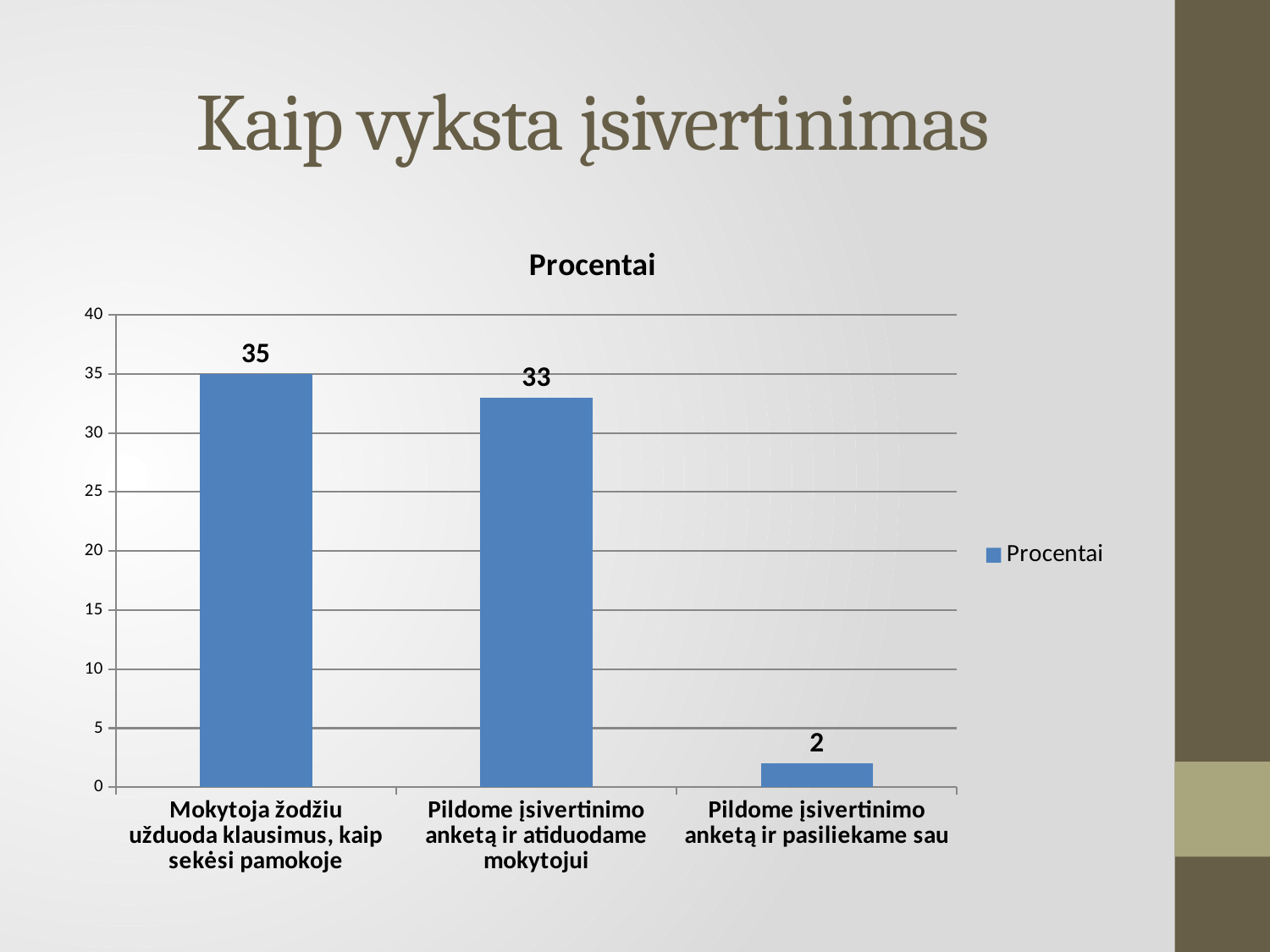
What kind of chart is shown on the slide? bar chart What is the difference between the values for "Pildome įsivertinimo anketą ir atiduodame mokytojui" and "Pildome įsivertinimo anketą ir pasiliekame sau"? 31 Is the value for "Pildome įsivertinimo anketą ir pasiliekame sau" greater or less than 5? less Which category has the highest value? Mokytoja žodžiu užduoda klausimus, kaip sekėsi pamokoje What is the value for "Pildome įsivertinimo anketą ir atiduodame mokytojui"? 33 How many series does the legend list? 1 What is the difference between the values for "Mokytoja žodžiu užduoda klausimus, kaip sekėsi pamokoje" and "Pildome įsivertinimo anketą ir atiduodame mokytojui"? 2 What is the value for "Pildome įsivertinimo anketą ir pasiliekame sau"? 2 How many categories are shown on the x axis? 3 Which is larger: the value for "Pildome įsivertinimo anketą ir atiduodame mokytojui" or for "Pildome įsivertinimo anketą ir pasiliekame sau"? Pildome įsivertinimo anketą ir atiduodame mokytojui What is the value for "Mokytoja žodžiu užduoda klausimus, kaip sekėsi pamokoje"? 35 Which category has the lowest value? Pildome įsivertinimo anketą ir pasiliekame sau